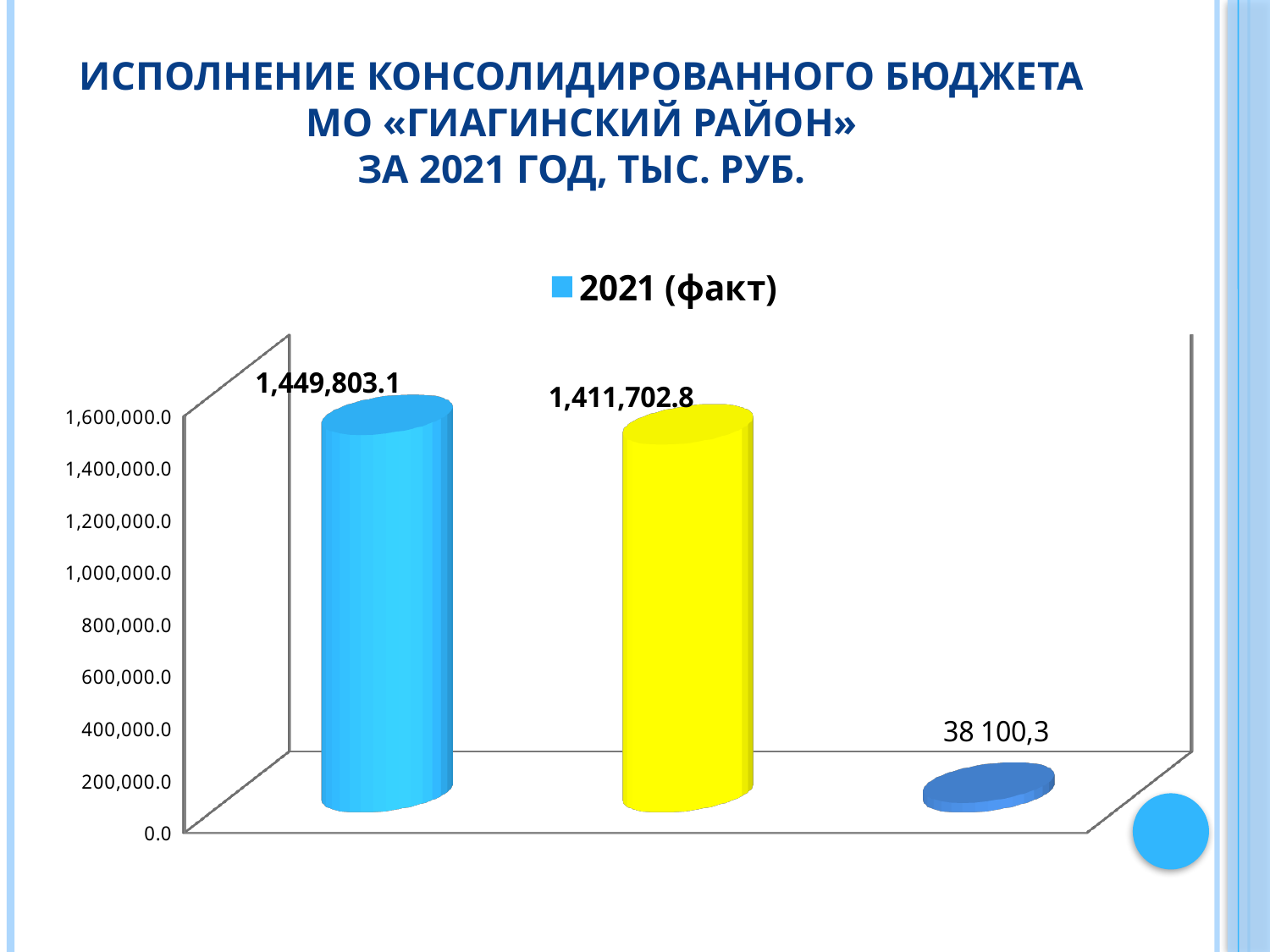
What kind of chart is shown on the slide? bar chart What is the legend entry shown above the chart? 2021 (факт) What is the data label on the yellow bar (the middle bar)? 1,411,702.8 What is the data label on the small dark blue bar on the right? 38 100,3 Which bar has the highest value: the blue, the yellow, or the dark blue one? the blue bar How many series does the legend list? 1 Is the value of the dark blue bar on the right greater or less than 200,000.0? less Which bar has the lowest value? the dark blue bar on the right Is the value of the yellow bar greater or less than 1,400,000.0? greater What is the data label on the blue bar (the first bar from the left)? 1,449,803.1 How many bars are plotted in the chart? 3 What is the difference between the blue bar's value (1,449,803.1) and the yellow bar's value (1,411,702.8)? 38,100.3